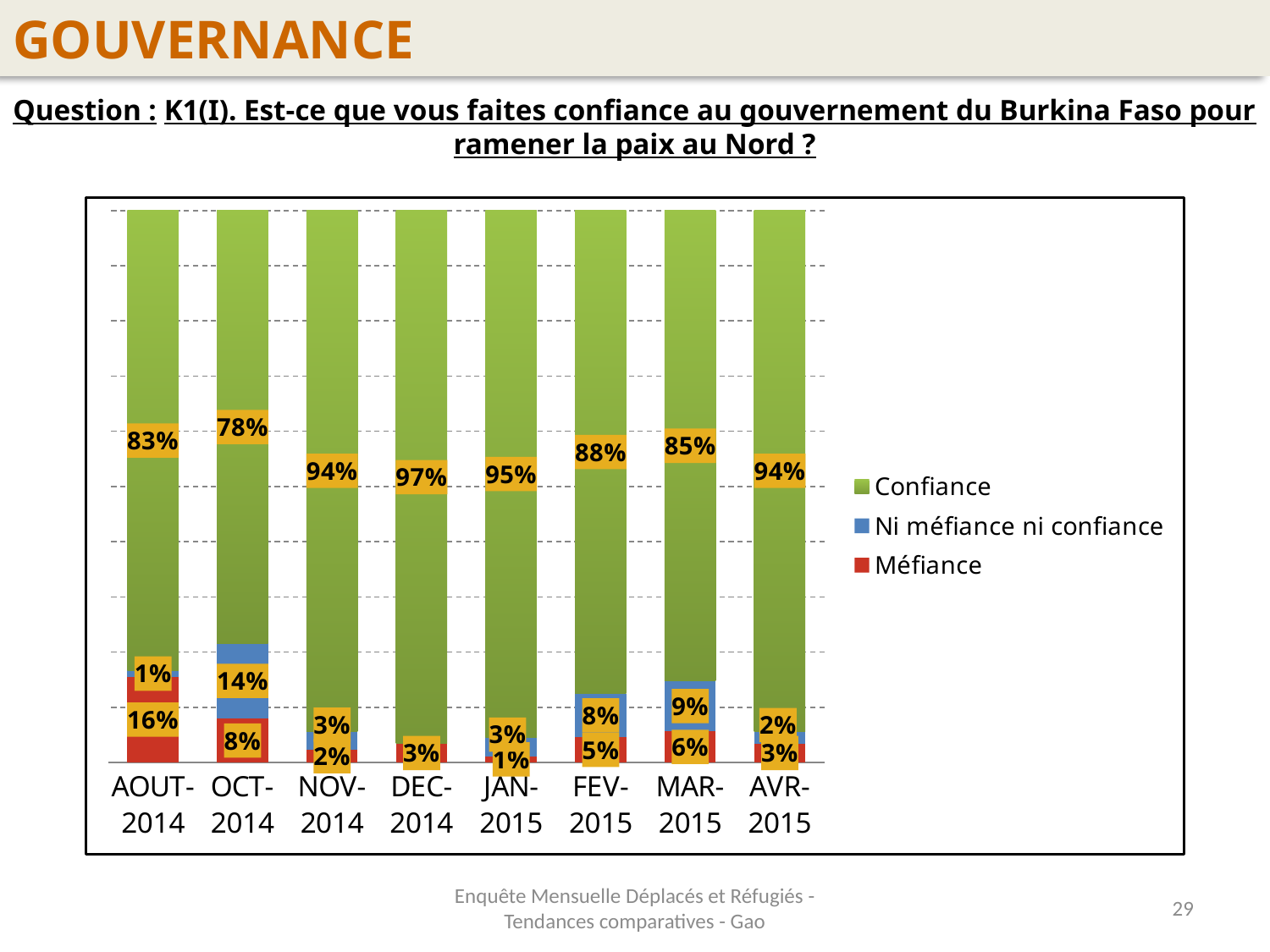
Which month has the larger Méfiance value, FEV-2015 or MAR-2015? MAR-2015 What kind of chart is shown on the slide? Stacked bar chart What is the value for Ni méfiance ni confiance in OCT-2014? 14% In which month is the Méfiance value highest? AOUT-2014 What is the difference between the Confiance value in DEC-2014 and in OCT-2014? 19 percentage points What is the value for Méfiance in AOUT-2014? 16% How many series does the legend list? 3 In which month is the Confiance value lowest? OCT-2014 In which month is the Confiance value highest? DEC-2014 What is the value for Confiance in DEC-2014? 97% Does the Confiance value rise or fall from OCT-2014 to DEC-2014? Rise How many months are shown on the x axis? 8